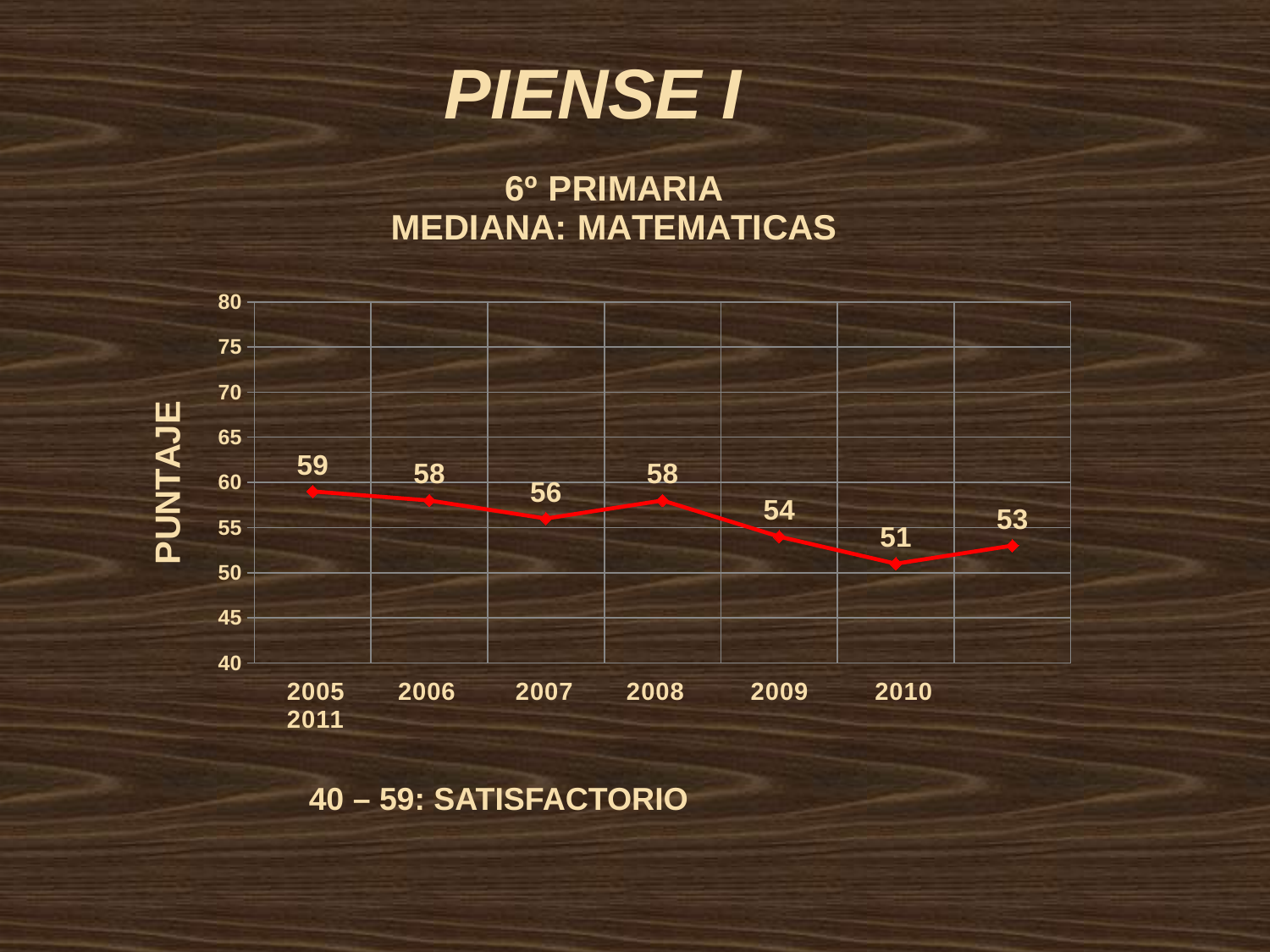
What is the value for 2005? 59 What is the title of the vertical axis? PUNTAJE How many data points are plotted on the line? 7 What is the value for 2007? 56 What kind of chart is shown on the slide? line chart Which year has the lowest value? 2010 Which is larger, the value for 2008 or the value for 2009? 2008 What is the value for 2009? 54 What is the difference between the values for 2005 and 2010? 8 What is the value for 2010? 51 Do the values generally rise or fall from 2005 to 2010? fall Which year has the highest value? 2005